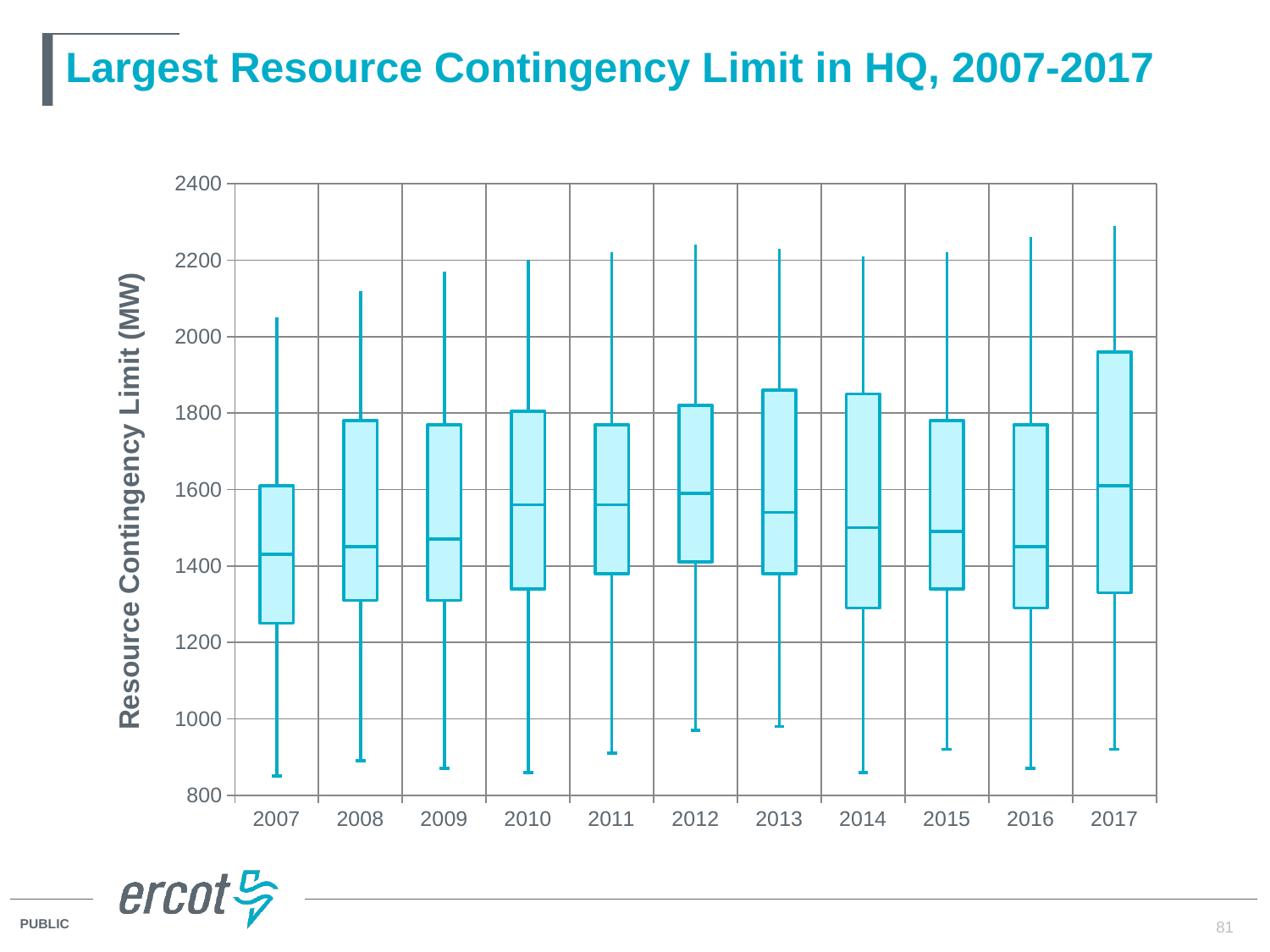
Is the top of the upper whisker for 2017 greater or less than 2200? greater How many years are plotted along the x axis? 11 What kind of chart is shown on the slide? Box plot (box-and-whisker chart) Is the median value for 2007 greater or less than 1600? less Is the top of the box (upper quartile) for 2017 greater or less than 1800? greater Which year has the highest upper quartile (top of the box)? 2017 Which year has the higher median, 2007 or 2017? 2017 What is the label on the y axis? Resource Contingency Limit (MW) From 2007 to 2012, do the upper whisker values rise or fall? rise